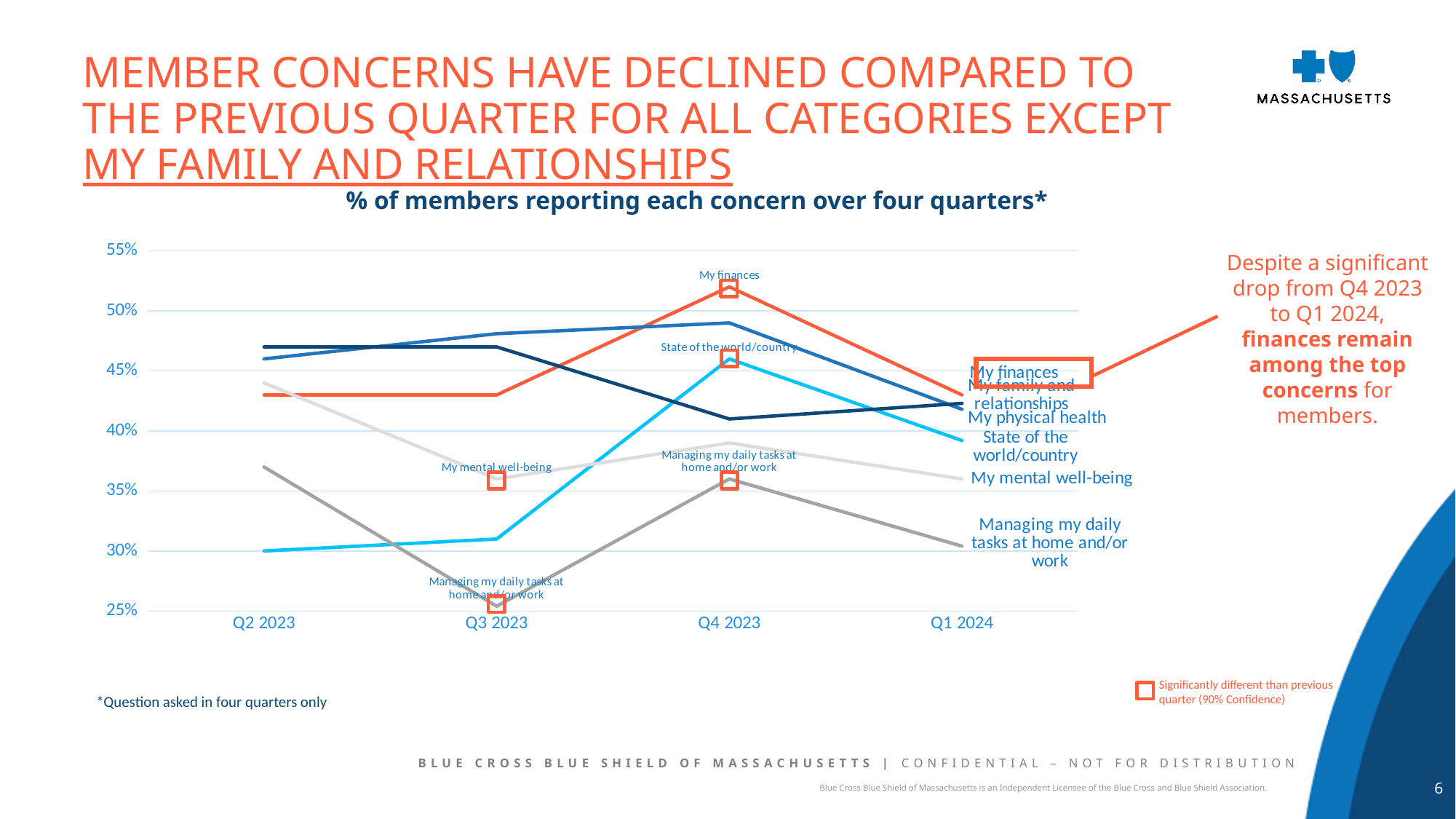
Is the value for My finances in Q4 2023 greater or less than 50%? greater What is the title of the chart? % of members reporting each concern over four quarters* Is the value for My mental well-being in Q2 2023 greater or less than 40%? greater Is the value for Managing my daily tasks at home and/or work in Q3 2023 greater or less than 30%? less Which concern has the lowest value in Q3 2023? Managing my daily tasks at home and/or work Which concern has the highest value in Q4 2023? My finances What kind of chart is shown on the slide? Line chart Which concern has the lowest value in Q1 2024? Managing my daily tasks at home and/or work In Q4 2023, which is larger: My finances or My mental well-being? My finances How many quarters are plotted along the x axis? 4 How many concern series are plotted in the chart? 6 Does the value for My finances rise or fall from Q4 2023 to Q1 2024? Fall